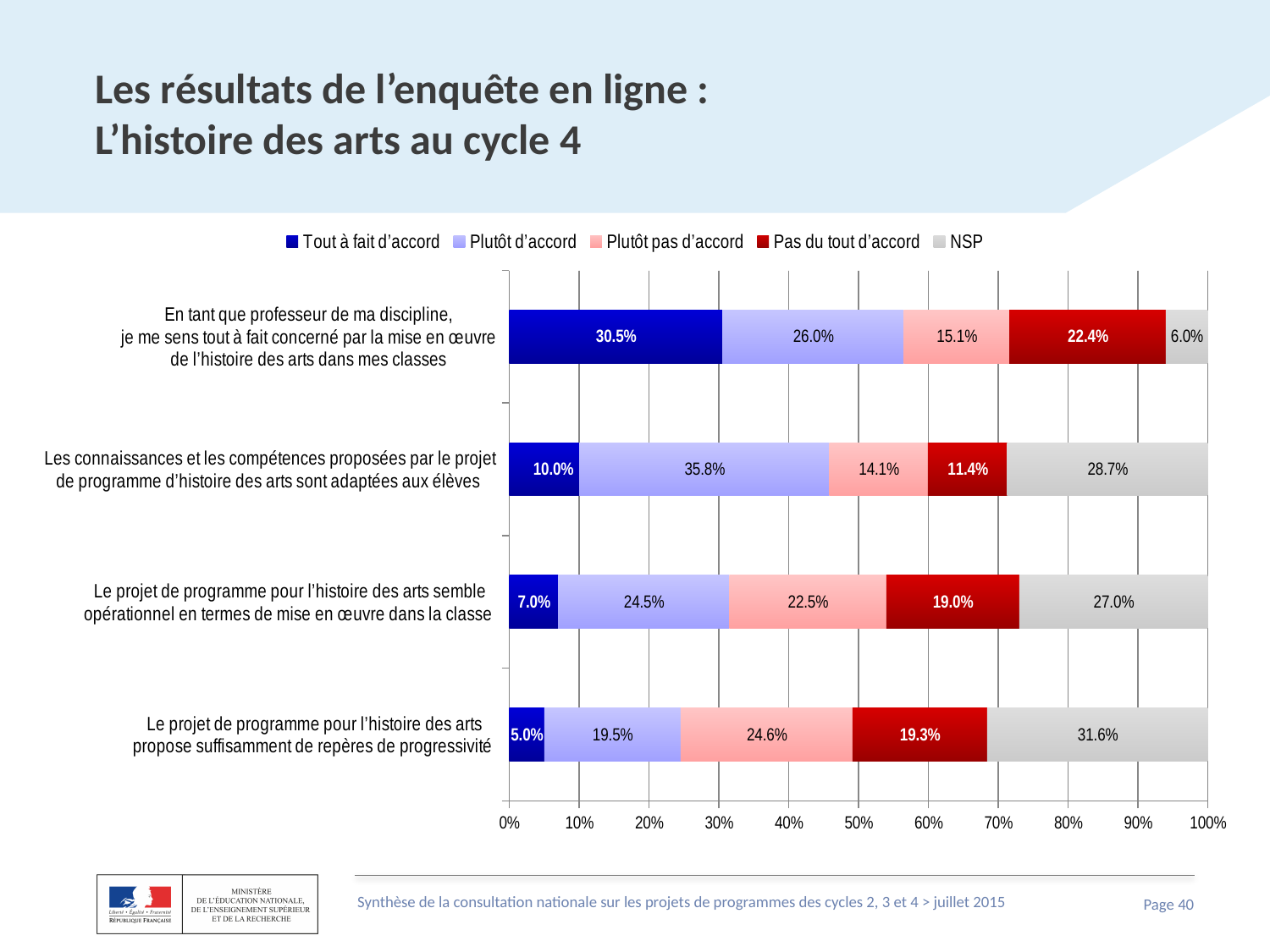
How many statements (bars) are shown in the chart? 4 For the statement "En tant que professeur de ma discipline...", what is the difference between the "Pas du tout d'accord" value and the NSP value? 16.4 percentage points What is the NSP value for the statement "Le projet de programme pour l'histoire des arts propose suffisamment de repères de progressivité"? 31.6% What is the total of the segments in the bar for "En tant que professeur de ma discipline, je me sens tout à fait concerné..."? 100.0% How many response categories does the legend list? 5 Which statement has the lowest "Tout à fait d'accord" share? Le projet de programme pour l'histoire des arts propose suffisamment de repères de progressivité What type of chart is shown on the slide? Stacked bar chart Which response category is shown in grey in the legend? NSP What percentage of respondents answered "Tout à fait d'accord" to the statement "En tant que professeur de ma discipline, je me sens tout à fait concerné par la mise en œuvre de l'histoire des arts dans mes classes"? 30.5% Which statement has the highest "Tout à fait d'accord" share? En tant que professeur de ma discipline, je me sens tout à fait concerné par la mise en œuvre de l'histoire des arts dans mes classes Which is larger: the "Plutôt pas d'accord" value for "Le projet de programme pour l'histoire des arts semble opérationnel..." or for "Le projet de programme pour l'histoire des arts propose suffisamment de repères de progressivité"? Le projet de programme pour l'histoire des arts propose suffisamment de repères de progressivité (24.6%) What is the "Plutôt d'accord" value for the statement "Les connaissances et les compétences proposées par le projet de programme d'histoire des arts sont adaptées aux élèves"? 35.8%